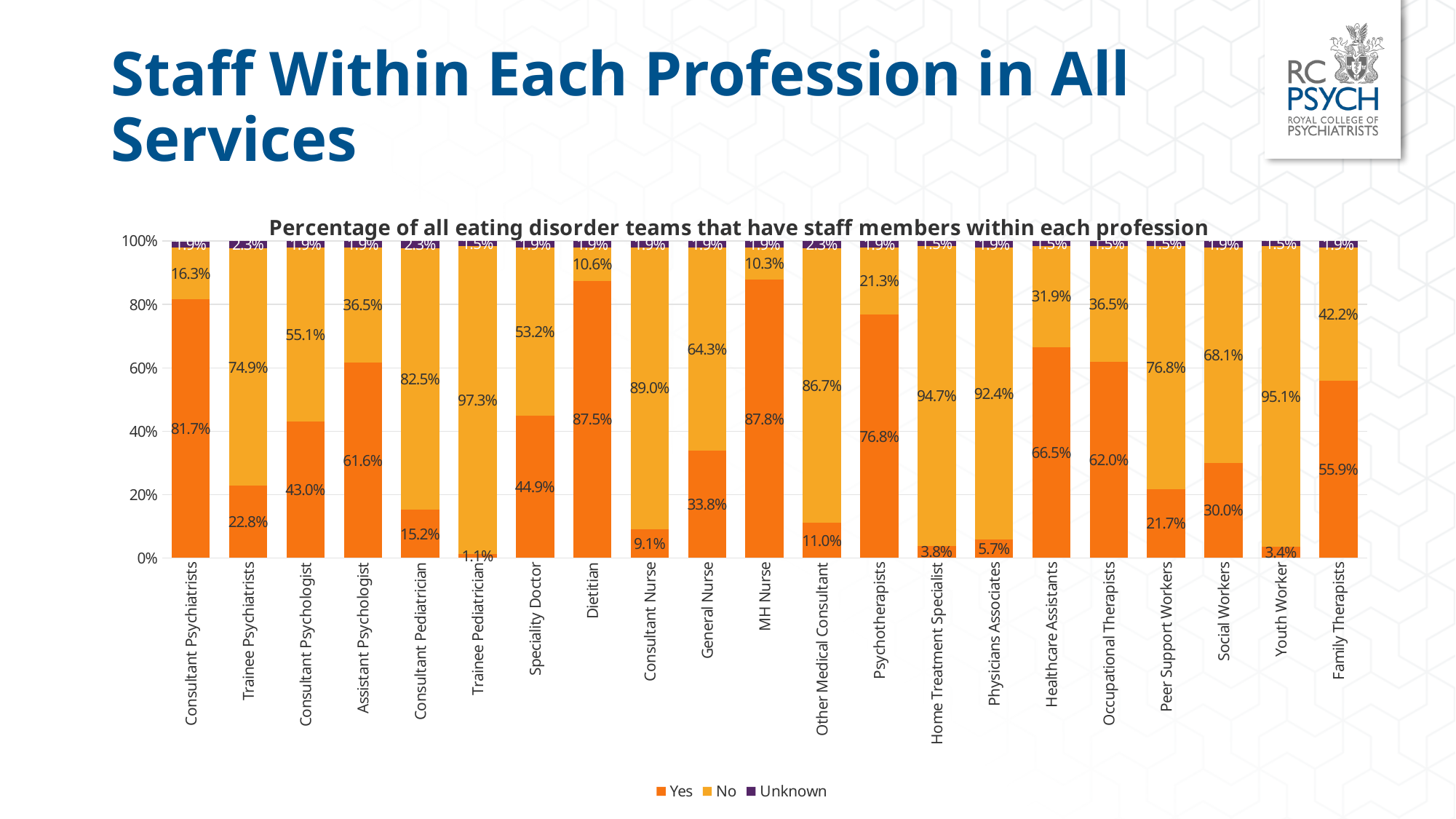
Which profession has the lowest 'Yes' percentage? Trainee Pediatrician How many series does the legend list? 3 What percentage of eating disorder teams answered 'Yes' for Consultant Psychiatrists? 81.7% Which profession has the highest 'No' percentage? Trainee Pediatrician What kind of chart is shown on the slide? Stacked bar chart What is the 'Yes' value for Family Therapists? 55.9% What is the 'Unknown' value for Other Medical Consultant? 2.3% What is the difference between the 'Yes' values for Consultant Psychiatrists and Trainee Psychiatrists? 58.9 percentage points How many professions are shown on the x axis? 21 Which has a larger 'Yes' value, Social Workers or Peer Support Workers? Social Workers Is the 'Yes' value for Healthcare Assistants greater or less than 60%? greater What is the 'No' value for Trainee Pediatrician? 97.3%